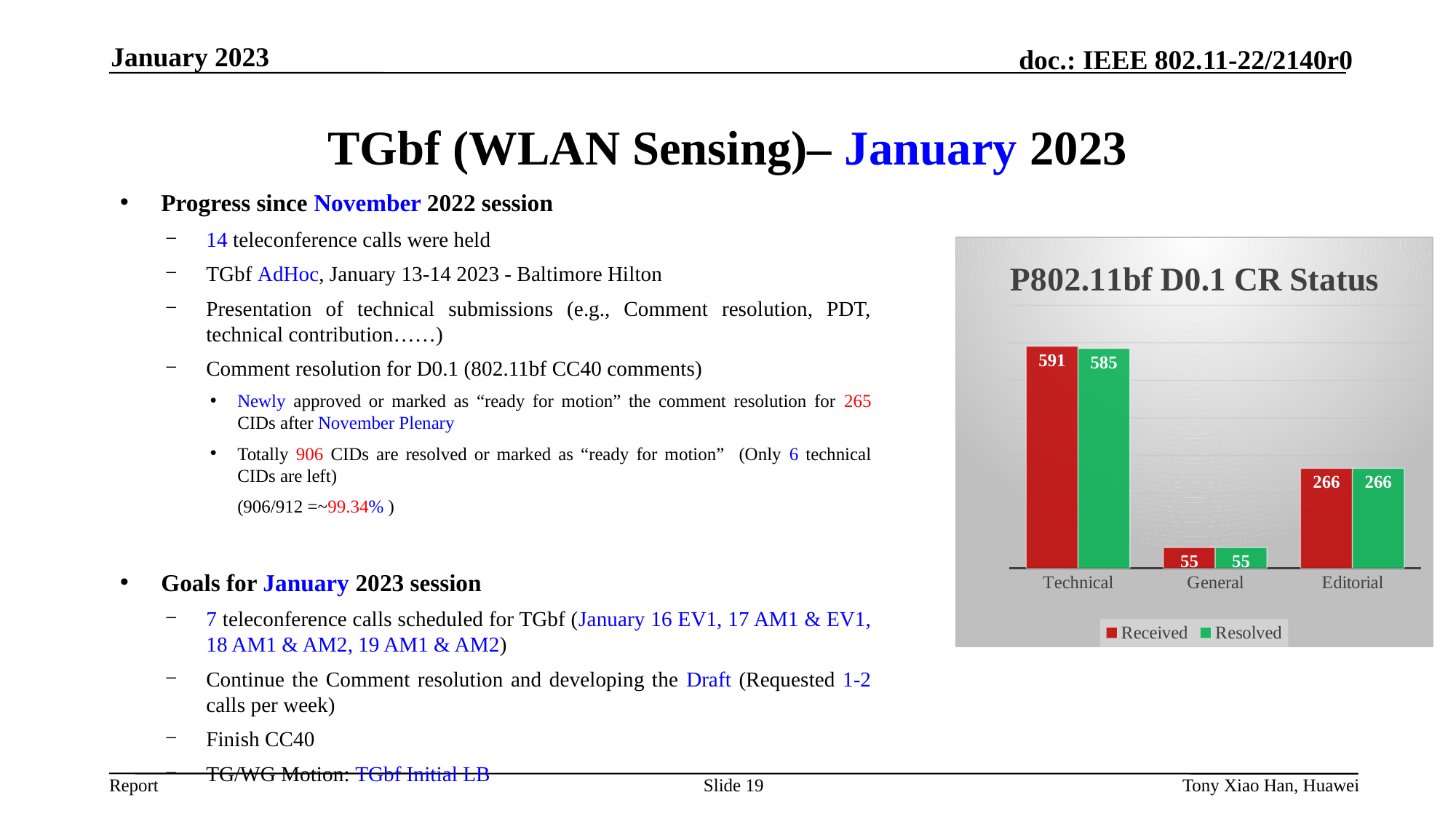
Which category has the lowest Resolved value? General What is the title of the chart? P802.11bf D0.1 CR Status What is the Resolved value for Editorial? 266 What is the difference between the Received and Resolved values for Technical? 6 What is the Received value for General? 55 What is the Received value for Technical? 591 What is the difference between the Received values for Technical and Editorial? 325 How many categories are shown on the x axis? 3 What is the Resolved value for Technical? 585 How many series does the legend list? 2 Which is larger, the Received value for Editorial or the Received value for General? Editorial Which category has the highest Received value? Technical